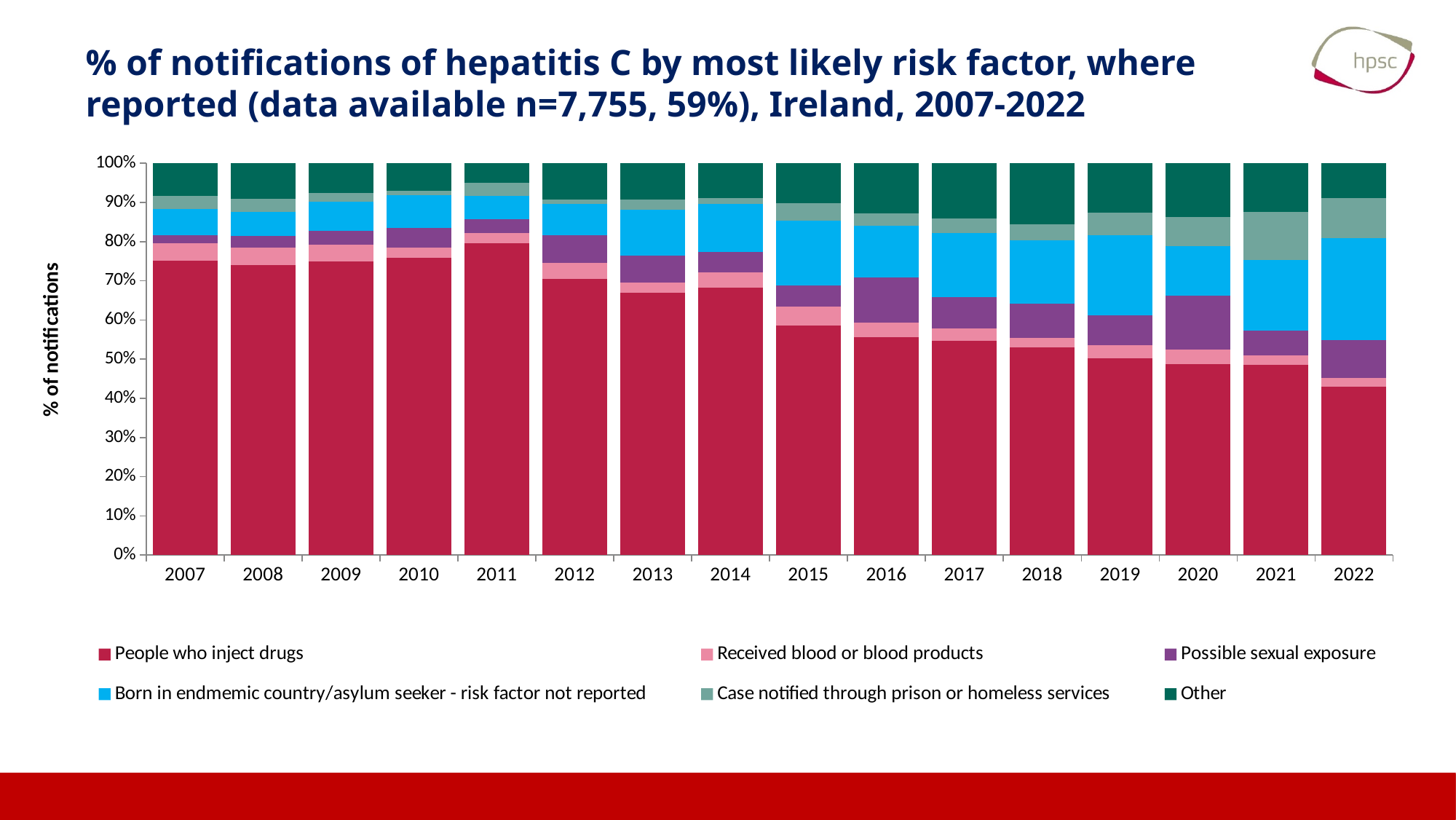
Which year has the larger share of People who inject drugs, 2007 or 2022? 2007 Does the share of People who inject drugs generally rise or fall from 2011 to 2022? fall What kind of chart is shown on the slide? stacked bar chart What does each stacked bar total? 100% Is the value for People who inject drugs in 2022 greater or less than 50%? less In which year is the share of People who inject drugs the lowest? 2022 Is the value for People who inject drugs in 2011 greater or less than 70%? greater Is the value for People who inject drugs in 2007 greater or less than 70%? greater Which series is shown in dark green at the top of each bar? Other How many years are shown along the x axis? 16 How many series does the legend list? 6 In which year is the share of People who inject drugs the highest? 2011